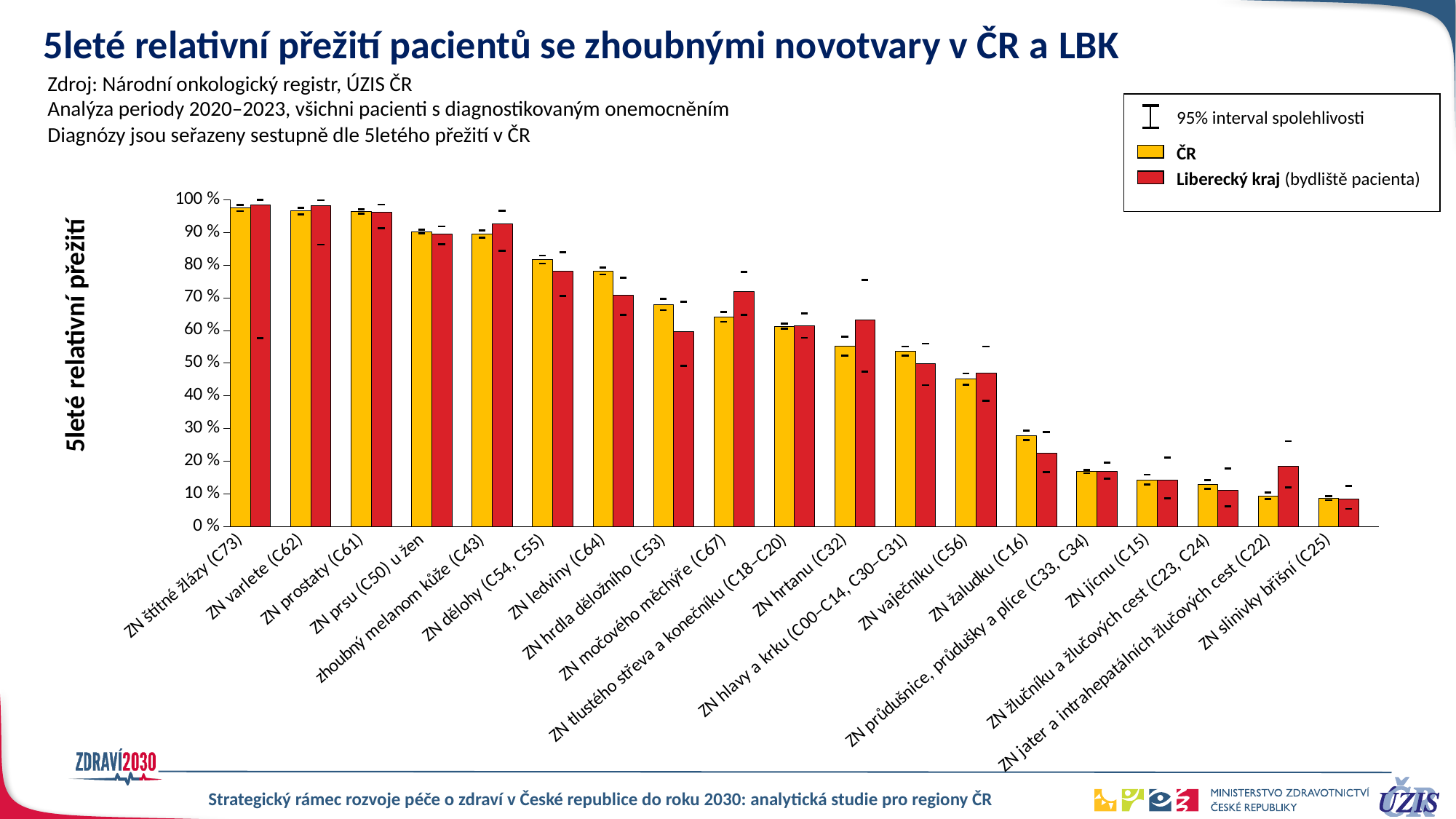
Is the Liberecký kraj value for ZN jater a intrahepatálních žlučových cest (C22) greater or less than 10 %? greater Is the ČR value for ZN žaludku (C16) greater or less than 30 %? less Which colour represents Liberecký kraj in the chart? red Which diagnosis has the lowest 5-year relative survival for ČR? ZN slinivky břišní (C25) Is the ČR value for ZN ledviny (C64) greater or less than 70 %? greater Do the ČR values rise or fall moving from left to right along the x axis? fall Which diagnosis has the highest 5-year relative survival for ČR? ZN štítné žlázy (C73) How many series does the legend list as bars? 2 For ZN ledviny (C64), which is larger: the ČR value or the Liberecký kraj value? ČR What kind of chart is shown on the slide? bar chart For ZN hrtanu (C32), which is larger: the ČR value or the Liberecký kraj value? Liberecký kraj How many diagnoses (categories) are shown on the x axis? 19